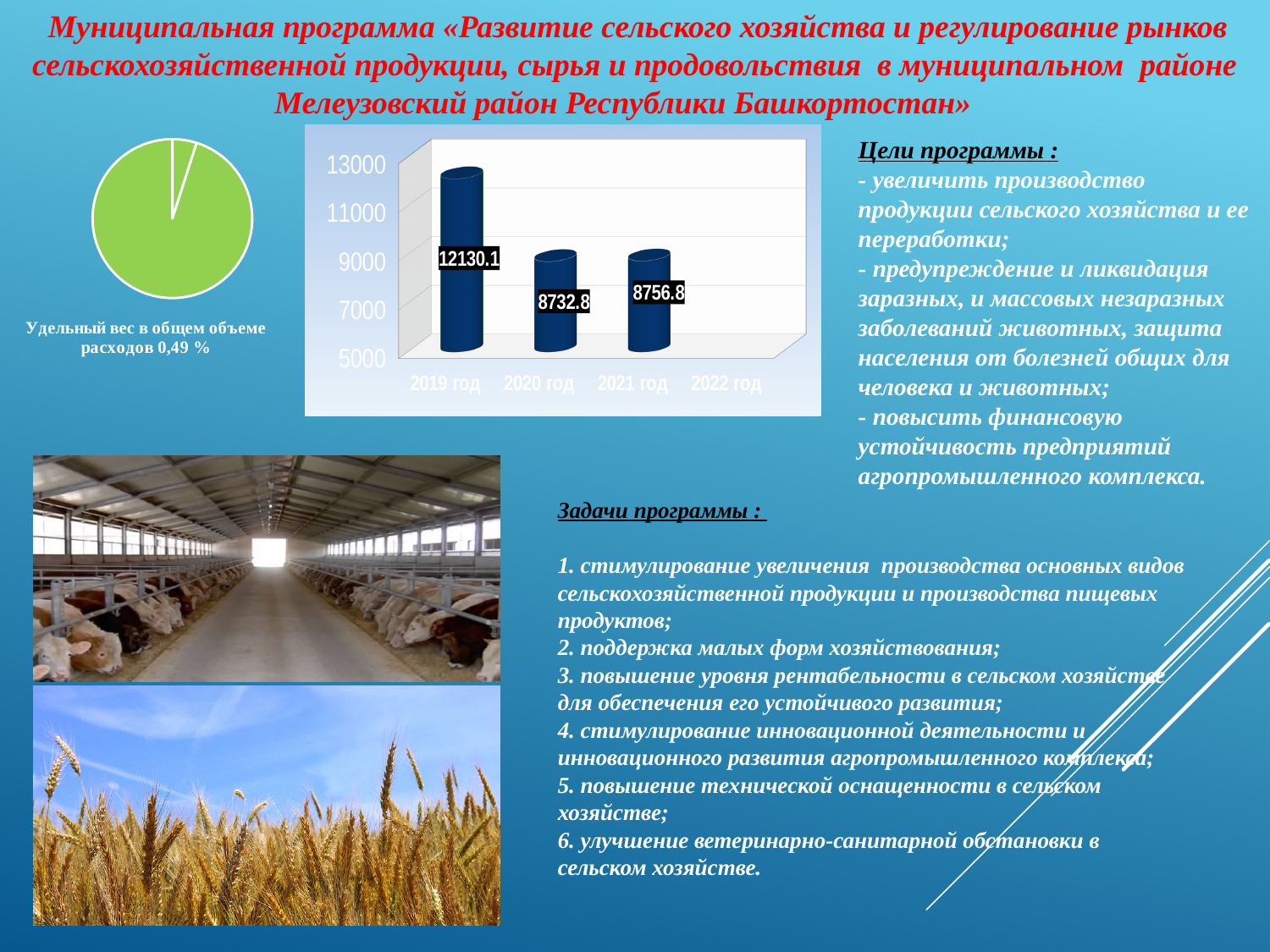
In the bar chart, what is the value for 2020 год? 8732.8 What kind of chart is the chart in the top centre of the slide? bar chart In the bar chart, what is the value for 2021 год? 8756.8 What kind of chart is the chart in the top left of the slide? pie chart In the bar chart, which of the plotted years has the lowest value? 2020 год In the bar chart, is the value for 2019 год greater or less than 11000? greater In the bar chart, which year has the highest value? 2019 год In the bar chart, does the value rise or fall from 2019 год to 2020 год? fall In the bar chart, how many bars are plotted? 3 In the bar chart, what is the difference between the values for 2019 год and 2020 год? 3397.3 In the bar chart, what is the value for 2019 год? 12130.1 In the bar chart, which is larger: the value for 2020 год or 2021 год? 2021 год